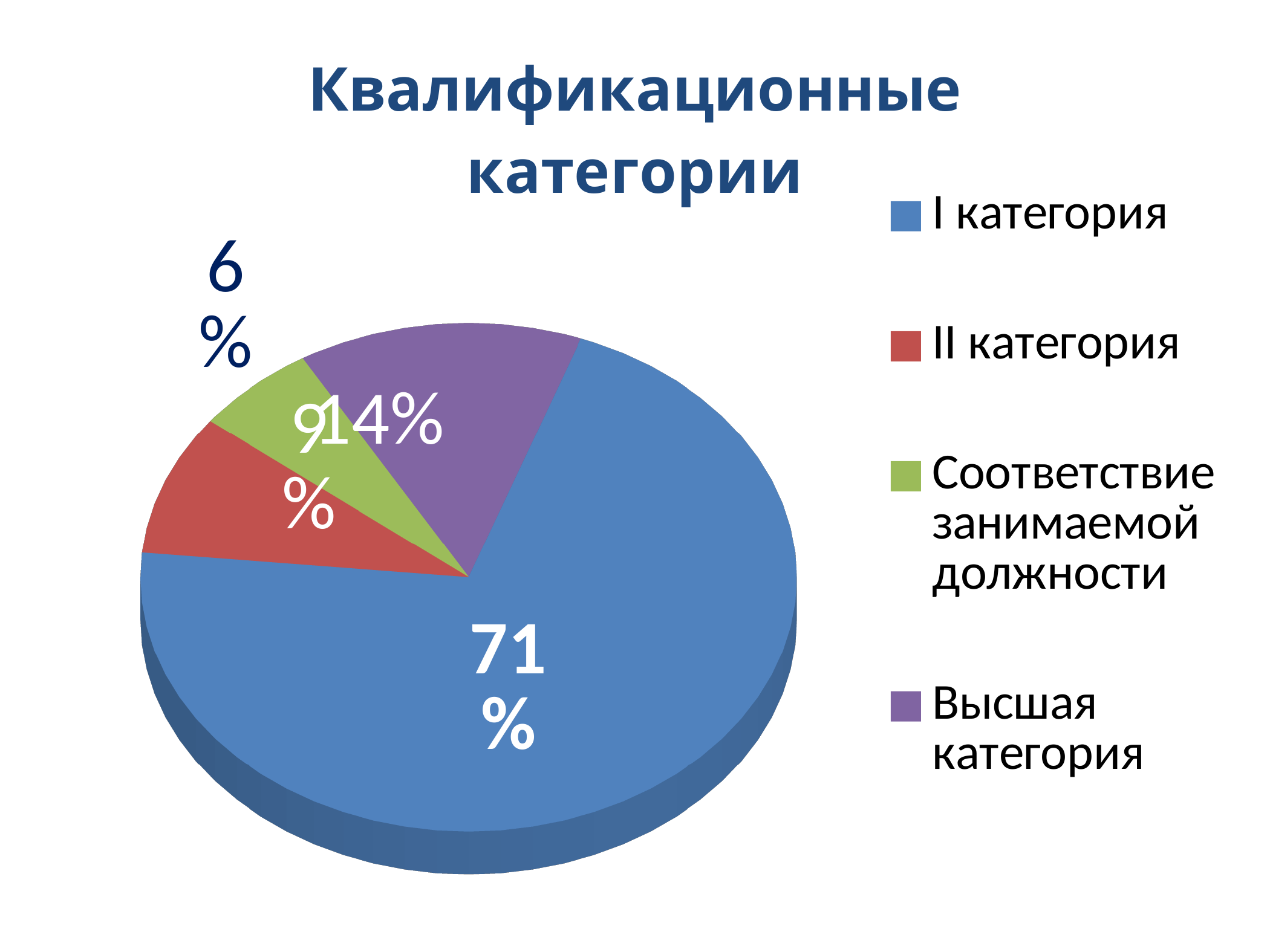
What percentage of the pie is Соответствие занимаемой должности? 6% What percentage of the pie is II категория? 9% Which category has the largest share of the pie? I категория What percentage of the pie is Высшая категория? 14% What colour is the slice for Высшая категория? purple Which category has the smallest share of the pie? Соответствие занимаемой должности How many categories does the legend list? 4 What percentage of the pie is I категория? 71% What is the title of the chart? Квалификационные категории What is the difference in percentage points between I категория and Высшая категория? 57 What type of chart is shown on the slide? pie chart Which is larger, the share for II категория or the share for Высшая категория? Высшая категория